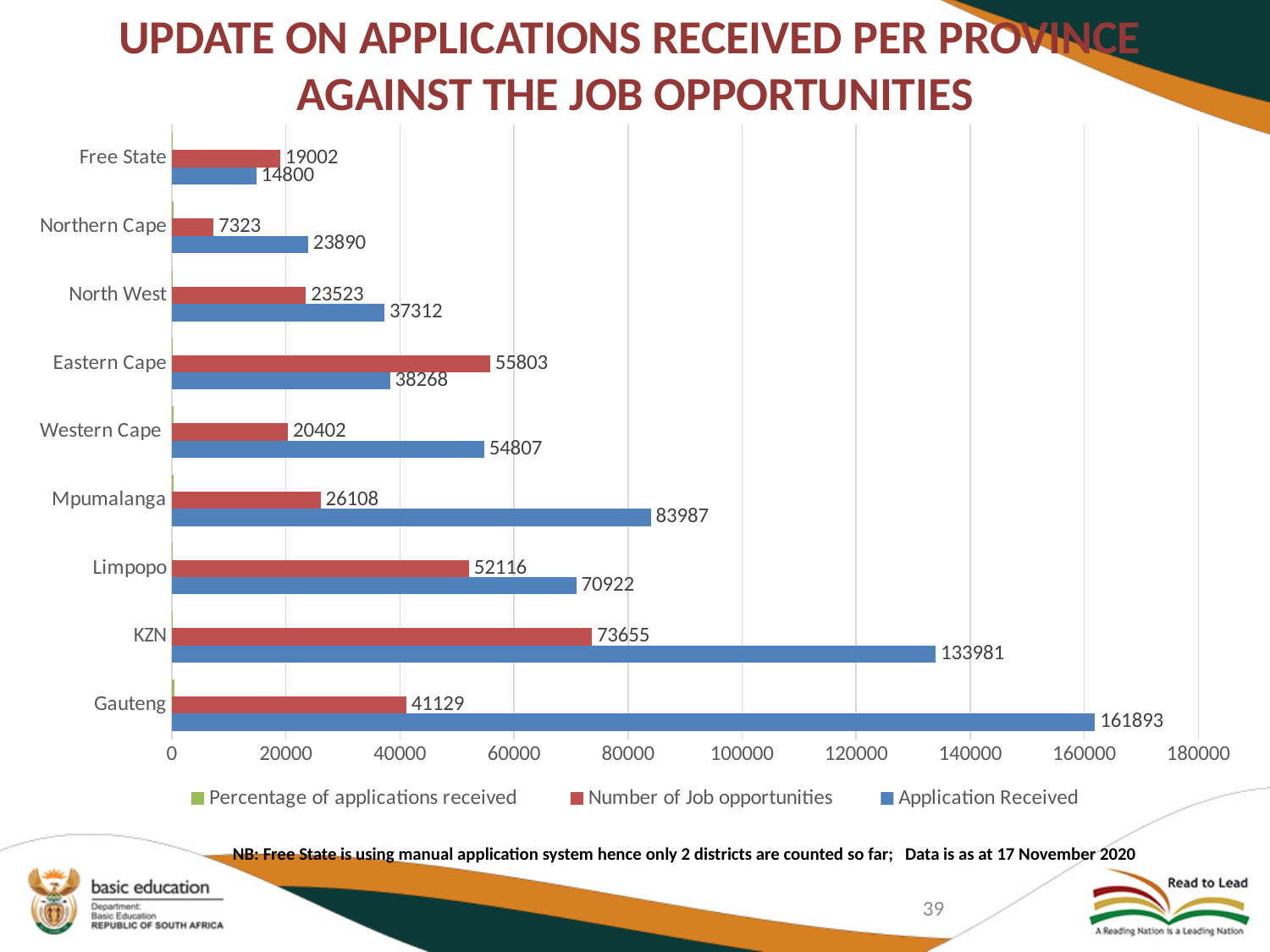
Which series is shown in blue in the legend? Application Received What is the number of Application Received for Mpumalanga? 83987 What is the difference between Application Received and Number of Job opportunities for KZN? 60326 What type of chart is shown on the slide? Bar chart Is the number of Application Received for Limpopo greater or less than 60000? greater For Eastern Cape, which is larger: Number of Job opportunities or Application Received? Number of Job opportunities How many series does the legend list? 3 What is the number of Application Received for Gauteng? 161893 How many provinces are shown on the chart? 9 Which province has the highest number of Application Received? Gauteng Which province has the lowest Number of Job opportunities? Northern Cape What is the Number of Job opportunities for KZN? 73655